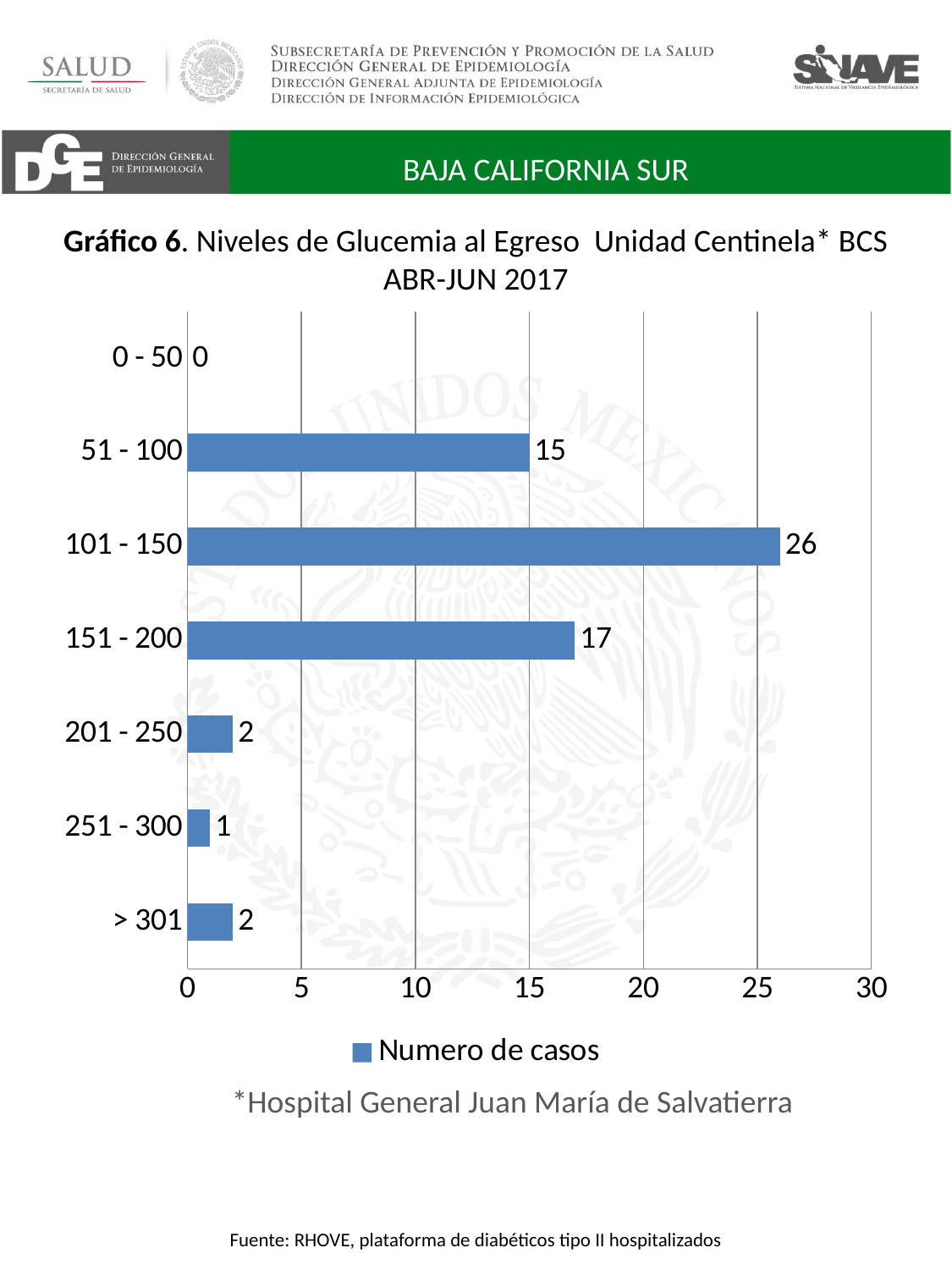
What is the total number of cases across all categories? 63 Which category has more cases, 51 - 100 or 151 - 200? 151 - 200 What is the number of cases for the 51 - 100 category? 15 Which glucose level category has the lowest number of cases? 0 - 50 Which glucose level category has the highest number of cases? 101 - 150 What is the number of cases for the 251 - 300 category? 1 How many glucose level categories are shown on the chart? 7 What is the number of cases for the 101 - 150 glucose level category? 26 How many series does the legend list? 1 What is the difference in number of cases between the 101 - 150 and 151 - 200 categories? 9 What kind of chart is shown on the slide? Bar chart What is the legend entry for the series shown in the chart? Numero de casos